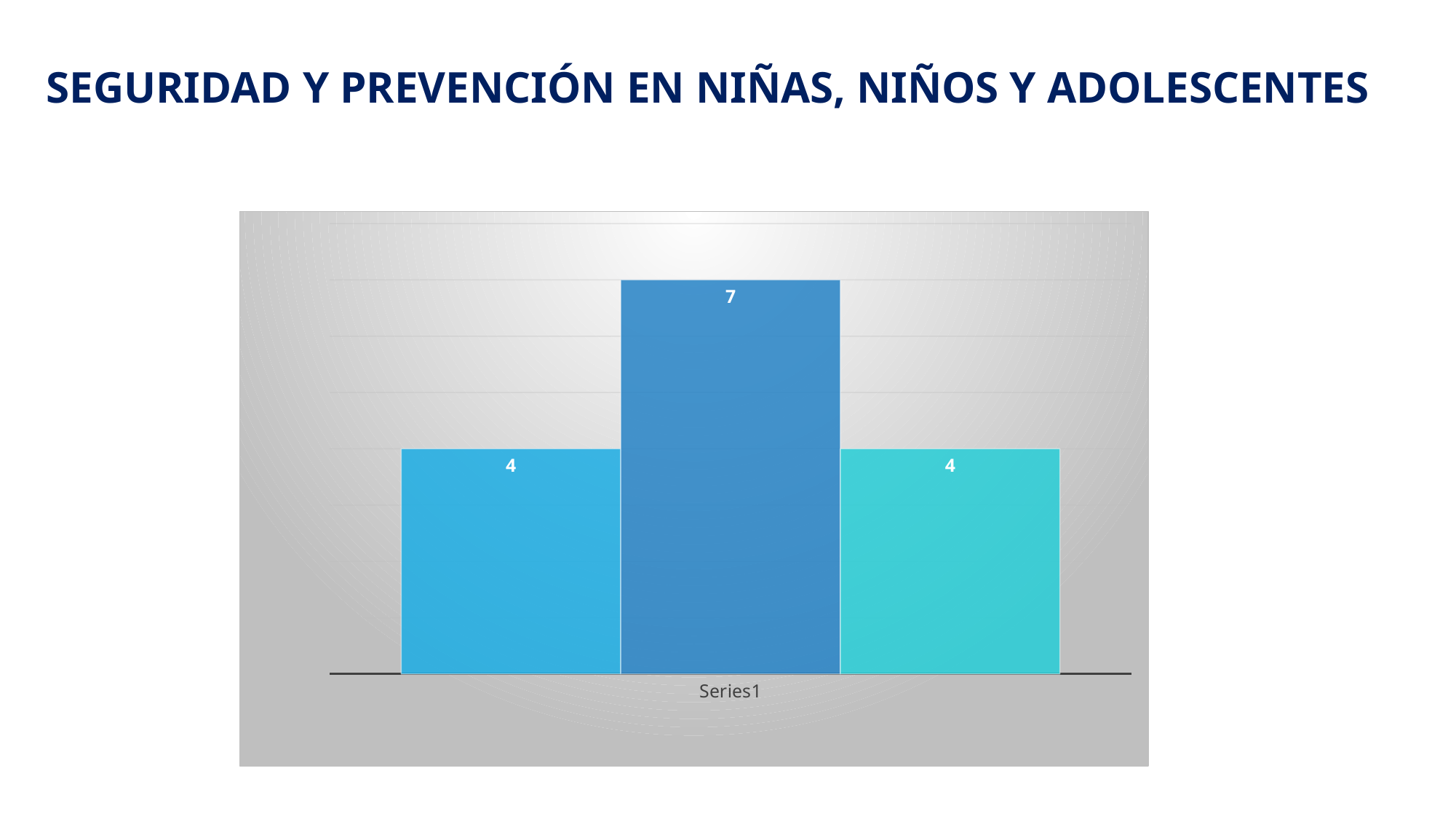
What label appears on the horizontal axis below the bars? Series1 Which bar has the highest value? the middle (dark blue) bar What is the value of the rightmost (teal) bar? 4 What is the value of the leftmost (light blue) bar? 4 What is the value of the middle (dark blue) bar? 7 Which is larger, the value of the middle bar or the value of the rightmost bar? the middle bar What is the title of the slide containing the chart? SEGURIDAD Y PREVENCIÓN EN NIÑAS, NIÑOS Y ADOLESCENTES What is the difference between the middle bar's value and the leftmost bar's value? 3 What kind of chart is shown on the slide? bar chart What is the total of the three bar values? 15 How many bars are plotted in the chart? 3